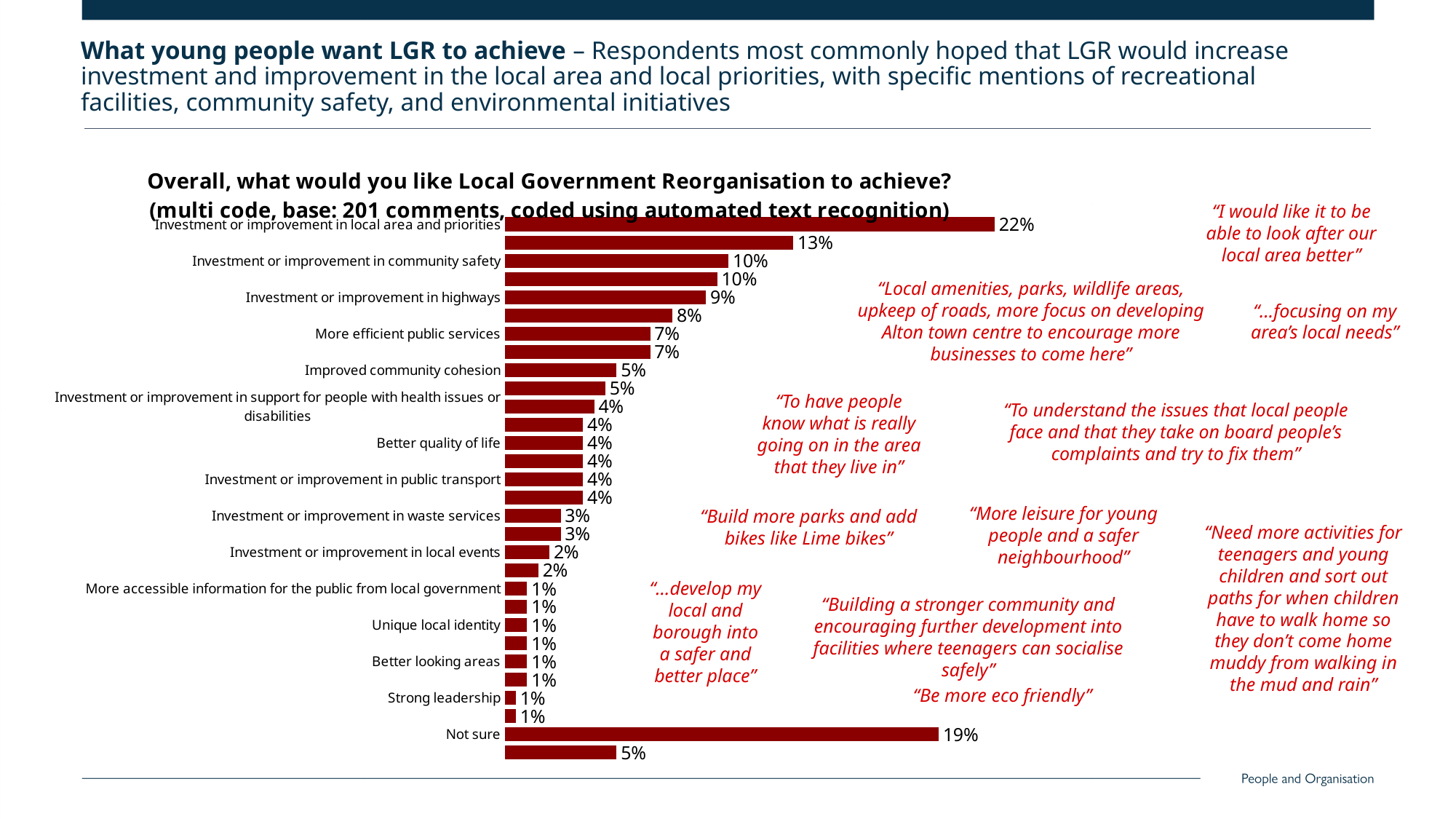
What is the value for investment or improvement in community safety? 10% Which category has the highest value in the chart? Investment or improvement in local area and priorities What percentage of respondents mentioned investment or improvement in local area and priorities? 22% What percentage of respondents mentioned more efficient public services? 7% What is the value for investment or improvement in waste services? 3% What percentage of respondents said 'Not sure'? 19% Which is larger: the value for investment or improvement in community safety or the value for investment or improvement in highways? Investment or improvement in community safety What kind of chart is shown on the slide? Bar chart What is the value for investment or improvement in highways? 9% What is the difference between the value for investment or improvement in local area and priorities and the value for 'Not sure'? 3 percentage points What is the value for strong leadership? 1% What is the base (number of comments) stated in the chart title? 201 comments